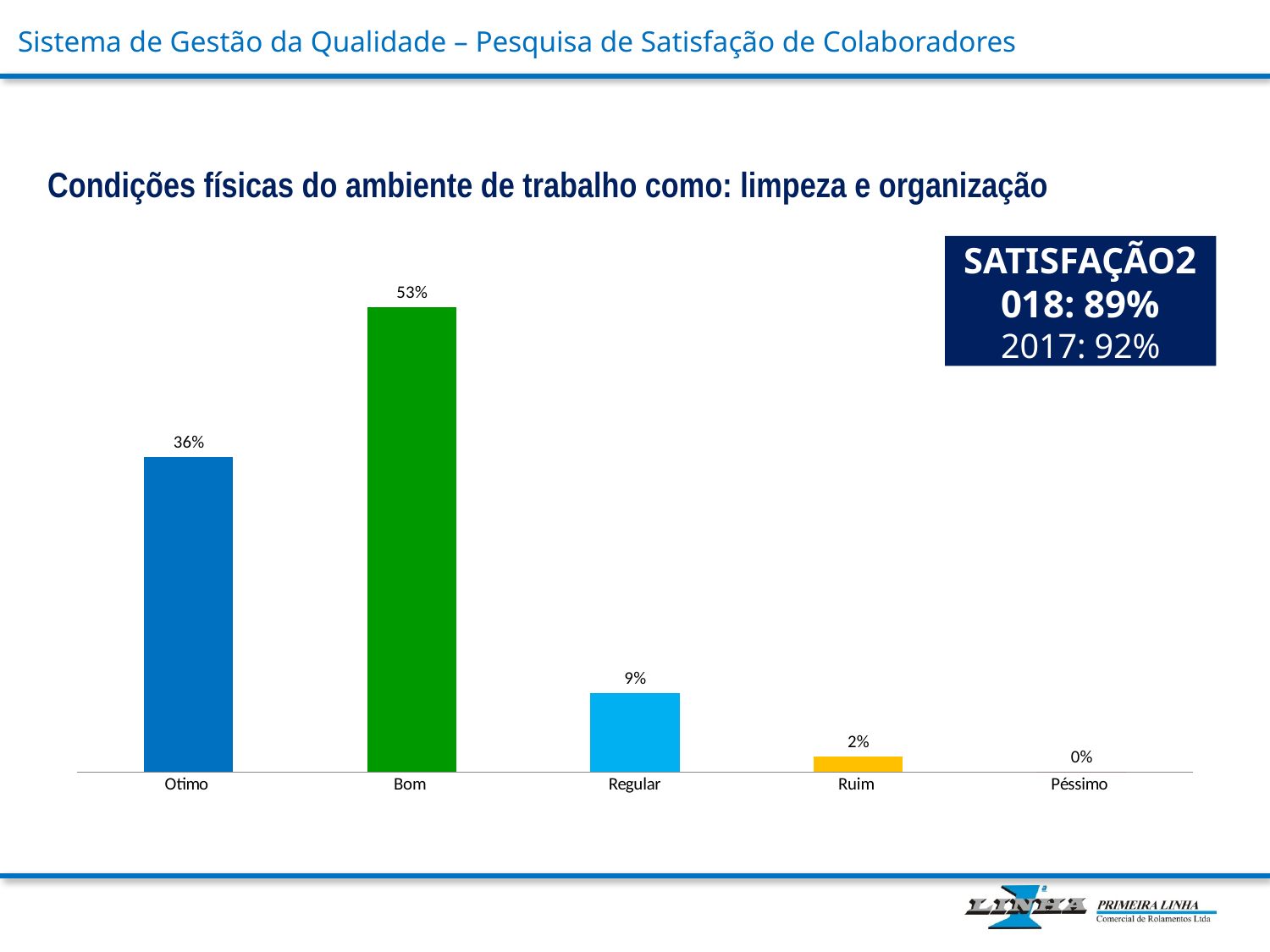
What colour is the bar for Bom? Green Which category has the highest value? Bom What is the value for Bom? 53% What is the value for Regular? 9% What is the value for Otimo? 36% How many categories are shown on the x axis? 5 What is the value for Ruim? 2% What is the difference between the values for Bom and Otimo? 17% Which is larger, the value for Regular or the value for Ruim? Regular What is the value for Péssimo? 0% Which category has the lowest value? Péssimo What kind of chart is shown on the slide? Bar chart